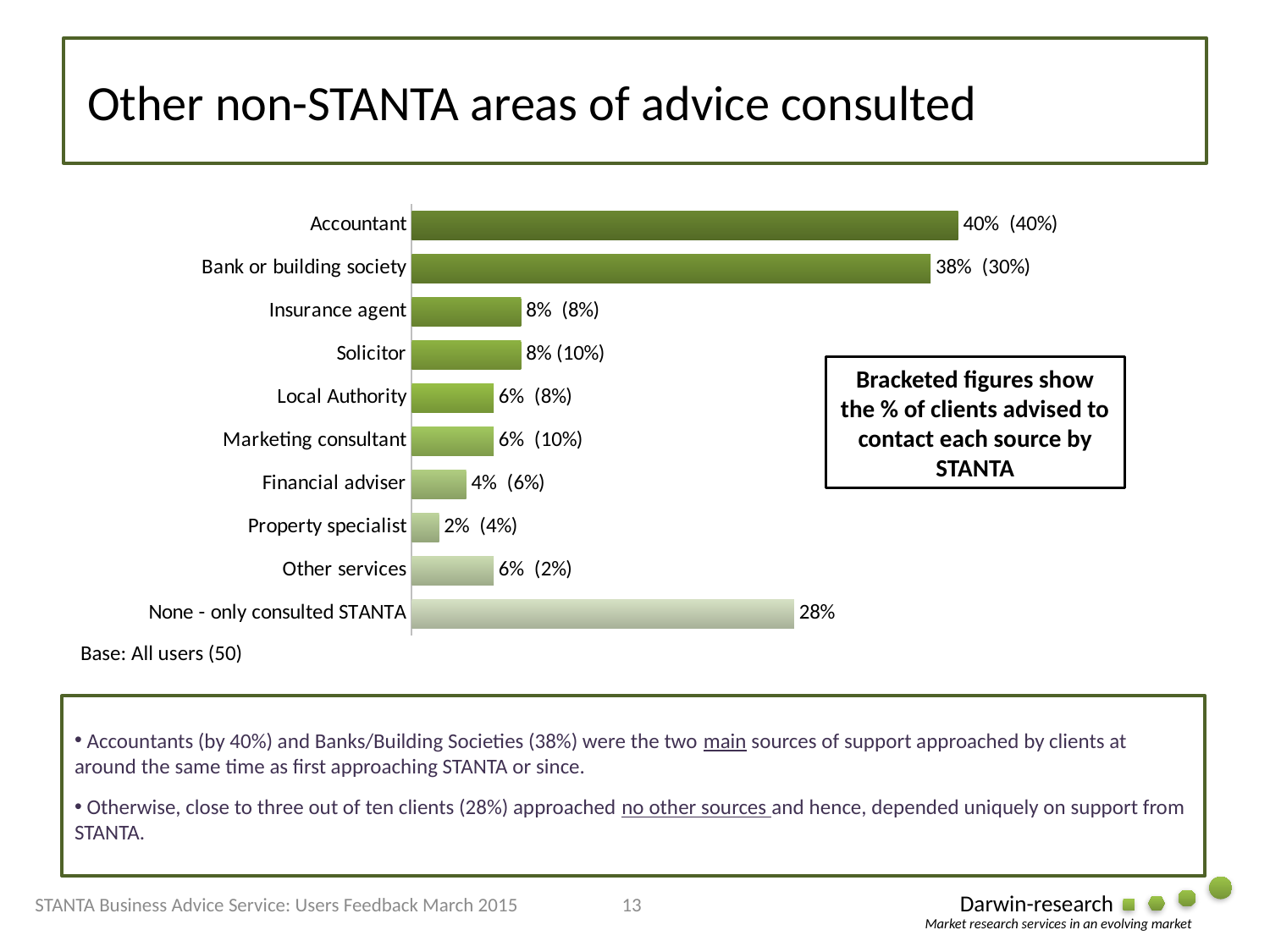
What is the bracketed figure shown for Solicitor? (10%) Which is larger: the percentage consulting an insurance agent or the percentage consulting a financial adviser? Insurance agent What percentage of clients consulted an accountant? 40% How many categories are shown in the chart? 10 What is the base (number of respondents) stated below the chart? All users (50) According to the text box on the slide, what do the bracketed figures show? The % of clients advised to contact each source by STANTA What is the difference between the percentage consulting an accountant and the percentage consulting a bank or building society? 2% What percentage of clients consulted a bank or building society? 38% What type of chart is shown on the slide? Bar chart Which category has the highest percentage of clients consulting it? Accountant Which category has the lowest percentage of clients consulting it? Property specialist What percentage of clients consulted no other sources (None - only consulted STANTA)? 28%